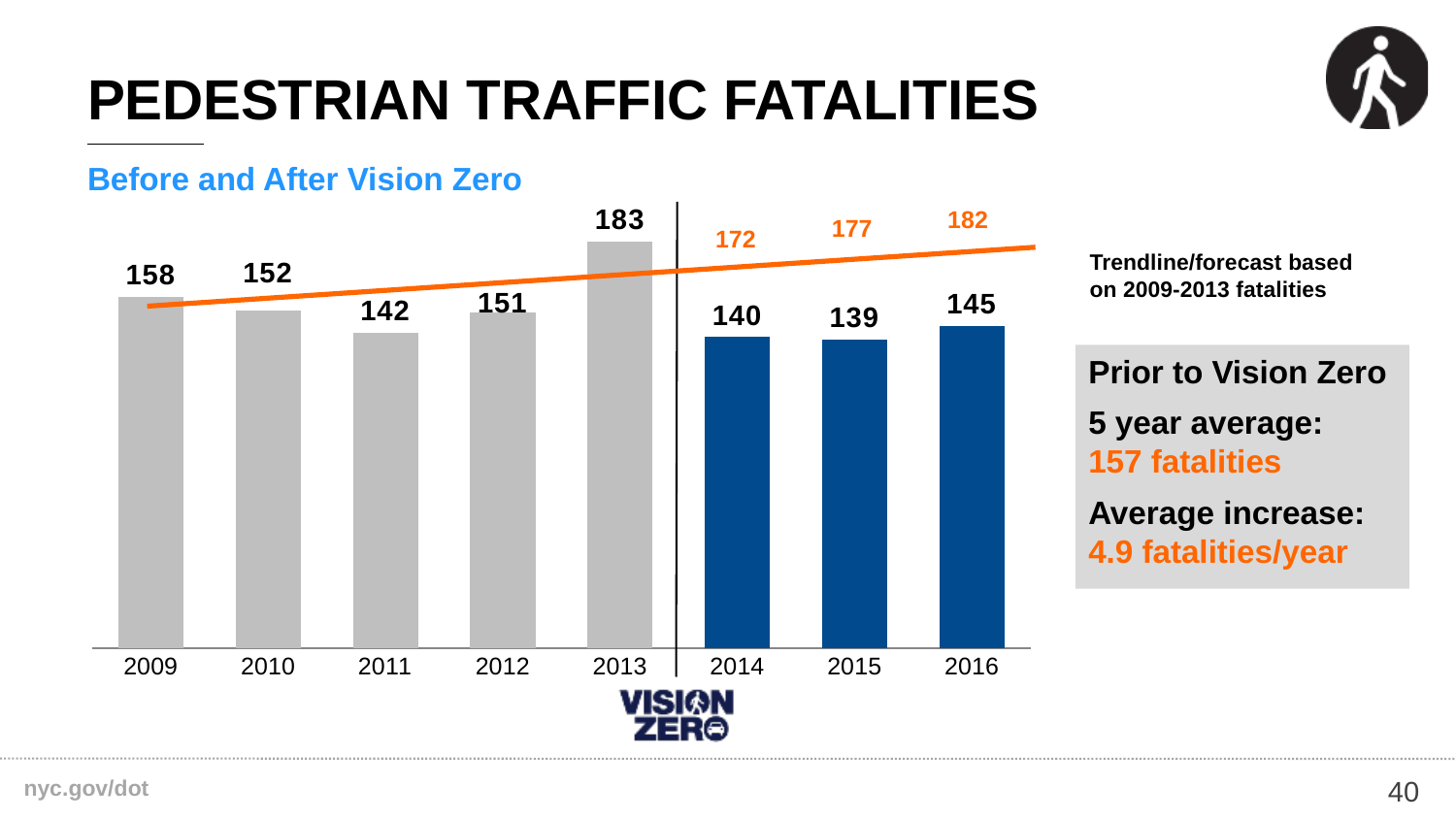
What is the subtitle of the chart? Before and After Vision Zero Do the trendline/forecast values rise or fall from 2014 to 2016? Rise What is the number of pedestrian traffic fatalities shown for 2013? 183 What is the trendline/forecast value shown for 2016? 182 What is the difference between the fatalities in 2013 and 2014? 43 Which year had more pedestrian fatalities, 2009 or 2016? 2009 What kind of chart is used to show the pedestrian traffic fatalities? Bar chart What is the number of pedestrian traffic fatalities shown for 2015? 139 What is the difference between the forecast value for 2014 and the actual fatalities in 2014? 32 How many years are shown on the x axis of the chart? 8 Which year has the highest number of pedestrian traffic fatalities? 2013 Which year has the lowest number of pedestrian traffic fatalities? 2015